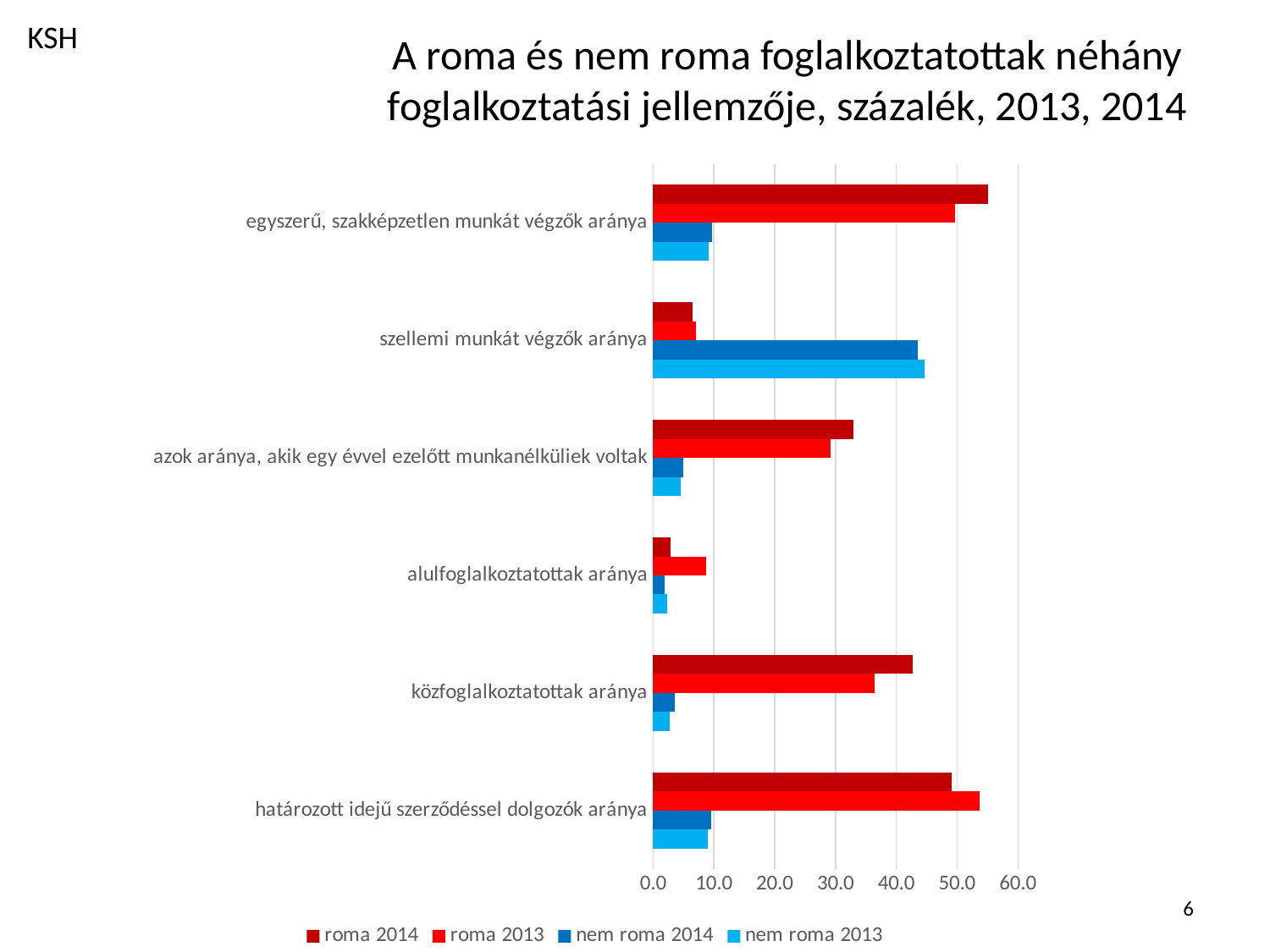
Which category has the lowest value for roma 2014? alulfoglalkoztatottak aránya Is the value for roma 2014 in 'egyszerű, szakképzetlen munkát végzők aránya' greater or less than 50.0? greater How many series does the legend list? 4 Which series is shown in the lightest blue colour in the legend? nem roma 2013 In 'határozott idejű szerződéssel dolgozók aránya', which is larger: roma 2013 or roma 2014? roma 2013 Which category has the highest value for roma 2014? egyszerű, szakképzetlen munkát végzők aránya What kind of chart is shown on the slide? bar chart Is the value for roma 2013 in 'közfoglalkoztatottak aránya' greater or less than 40.0? less How many categories are shown on the vertical axis of the chart? 6 Is the value for nem roma 2013 in 'szellemi munkát végzők aránya' greater or less than 40.0? greater In 'szellemi munkát végzők aránya', which is larger: roma 2014 or nem roma 2014? nem roma 2014